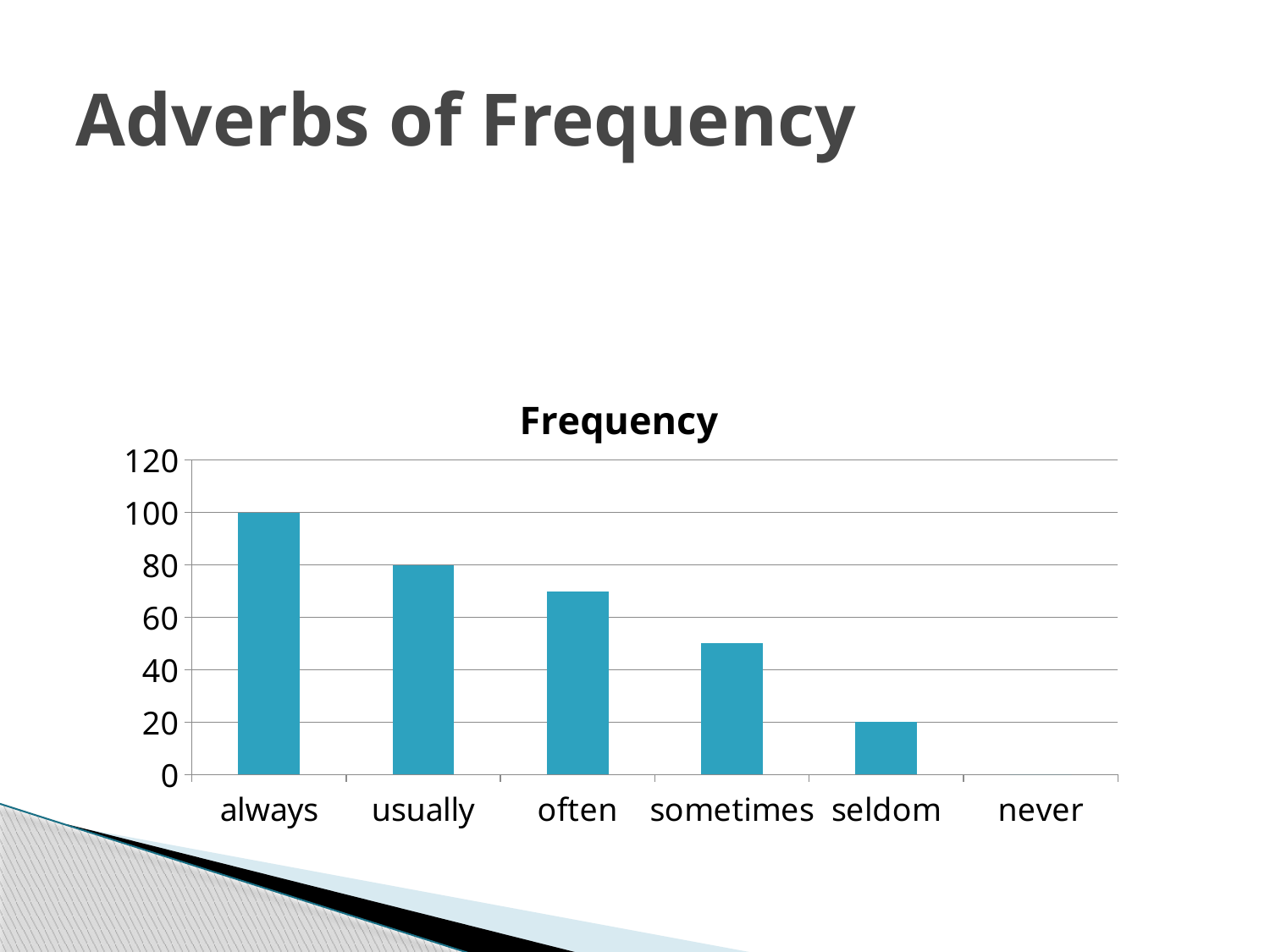
What is the value for "never" in the Frequency chart? 0 How many categories are shown on the x axis of the Frequency chart? 6 What is the difference between the values for "always" and "usually" in the Frequency chart? 20 What is the value for "seldom" in the Frequency chart? 20 Which category has the lowest value in the Frequency chart? never Is the value for "often" in the Frequency chart greater or less than 60? greater Is the value for "sometimes" in the Frequency chart greater or less than 60? less Which category has the highest value in the Frequency chart? always What is the value for "usually" in the Frequency chart? 80 Do the values in the Frequency chart rise or fall from left to right along the x axis? fall Which is larger in the Frequency chart, the value for "often" or the value for "sometimes"? often What is the value for "always" in the Frequency chart? 100